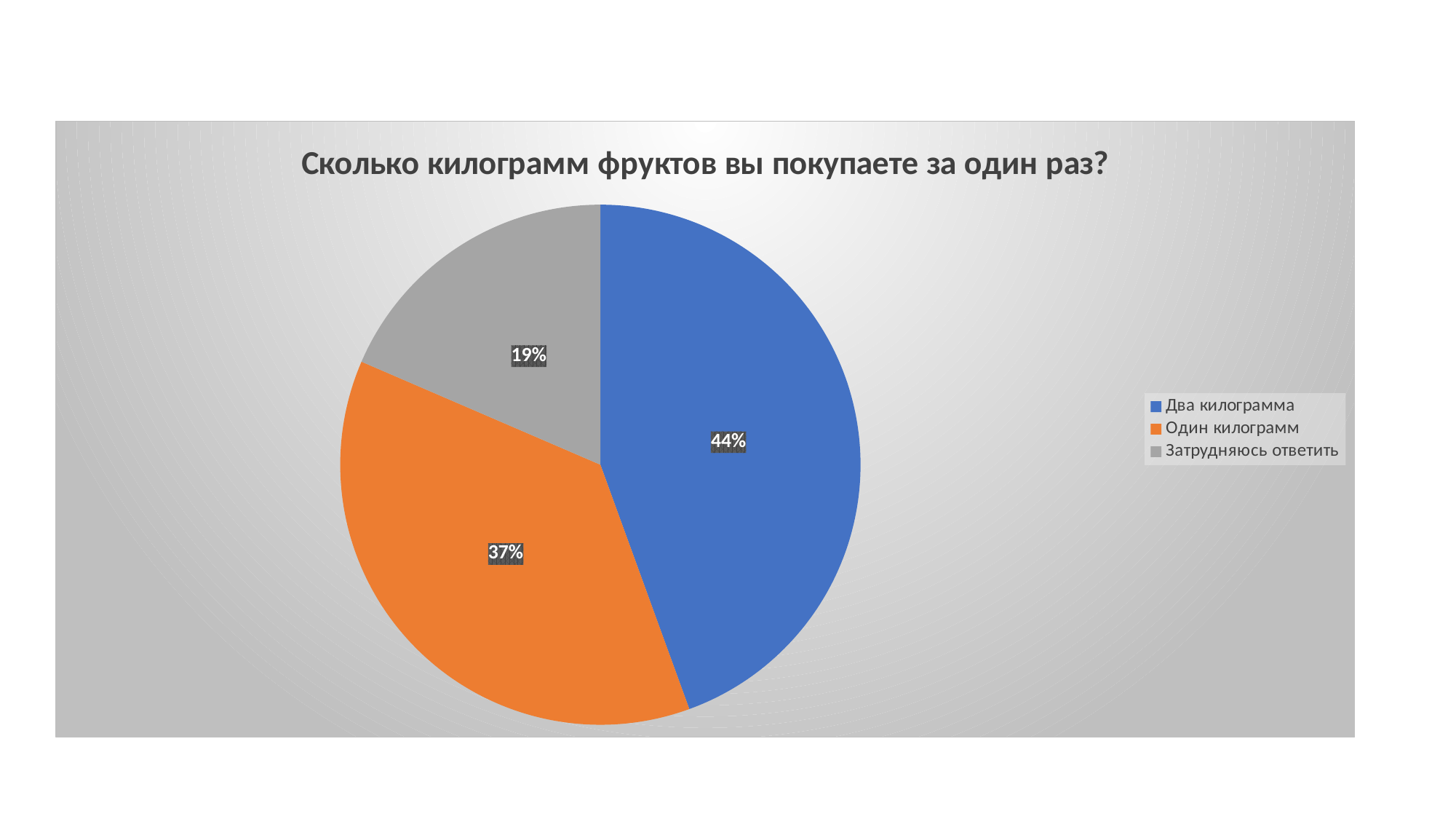
Which colour represents "Один килограмм" in the legend? orange What share of the pie is labelled for "Один килограмм"? 37% What share of the pie is labelled for "Два килограмма"? 44% What is the difference in percentage points between "Один килограмм" and "Затрудняюсь ответить"? 18 Which category has the largest slice of the pie? Два килограмма How many slices does the pie chart have? 3 What is the difference in percentage points between "Два килограмма" and "Один килограмм"? 7 Which is larger: the slice for "Один килограмм" or the slice for "Затрудняюсь ответить"? Один килограмм Which category has the smallest slice of the pie? Затрудняюсь ответить What share of the pie is labelled for "Затрудняюсь ответить"? 19% What is the title of the chart? Сколько килограмм фруктов вы покупаете за один раз? What kind of chart is shown on the slide? pie chart